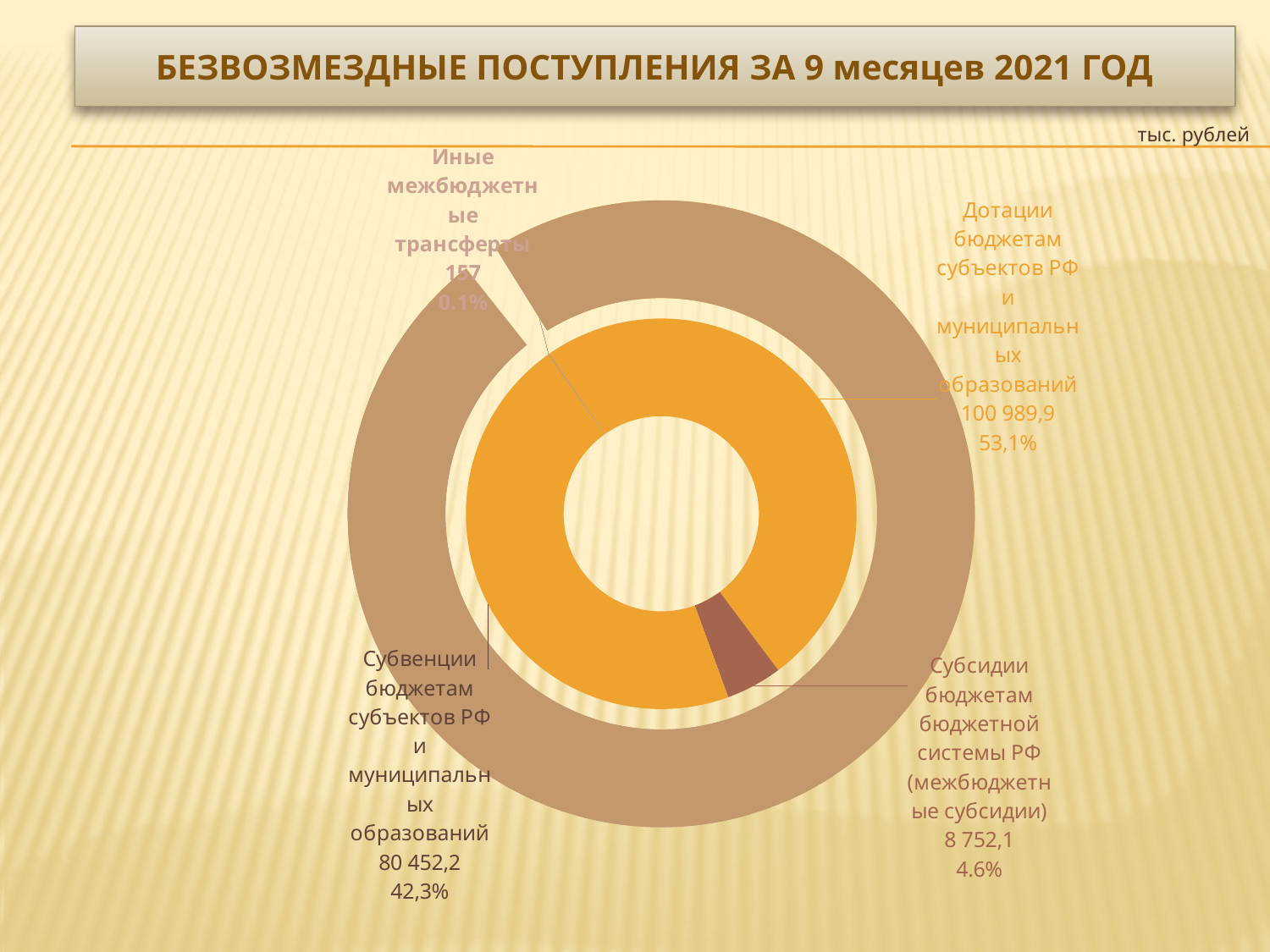
Which category has the highest value? Дотации бюджетам субъектов РФ и муниципальных образований What is the value for Дотации бюджетам субъектов РФ и муниципальных образований? 100 989,9 Which is larger, the value for Субвенции or the value for Субсидии? Субвенции What is the value for Иные межбюджетные трансферты? 157 What is the value for Субвенции бюджетам субъектов РФ и муниципальных образований? 80 452,2 Which category has the lowest value? Иные межбюджетные трансферты What share of the chart does Дотации бюджетам субъектов РФ и муниципальных образований represent? 53,1% What kind of chart is shown on the slide? Doughnut (pie) chart How many categories are shown in the chart? 4 What is the value for Субсидии бюджетам бюджетной системы РФ (межбюджетные субсидии)? 8 752,1 What is the difference between the values for Дотации and Субвенции? 20 537,7 What share of the chart does Субсидии бюджетам бюджетной системы РФ (межбюджетные субсидии) represent? 4.6%